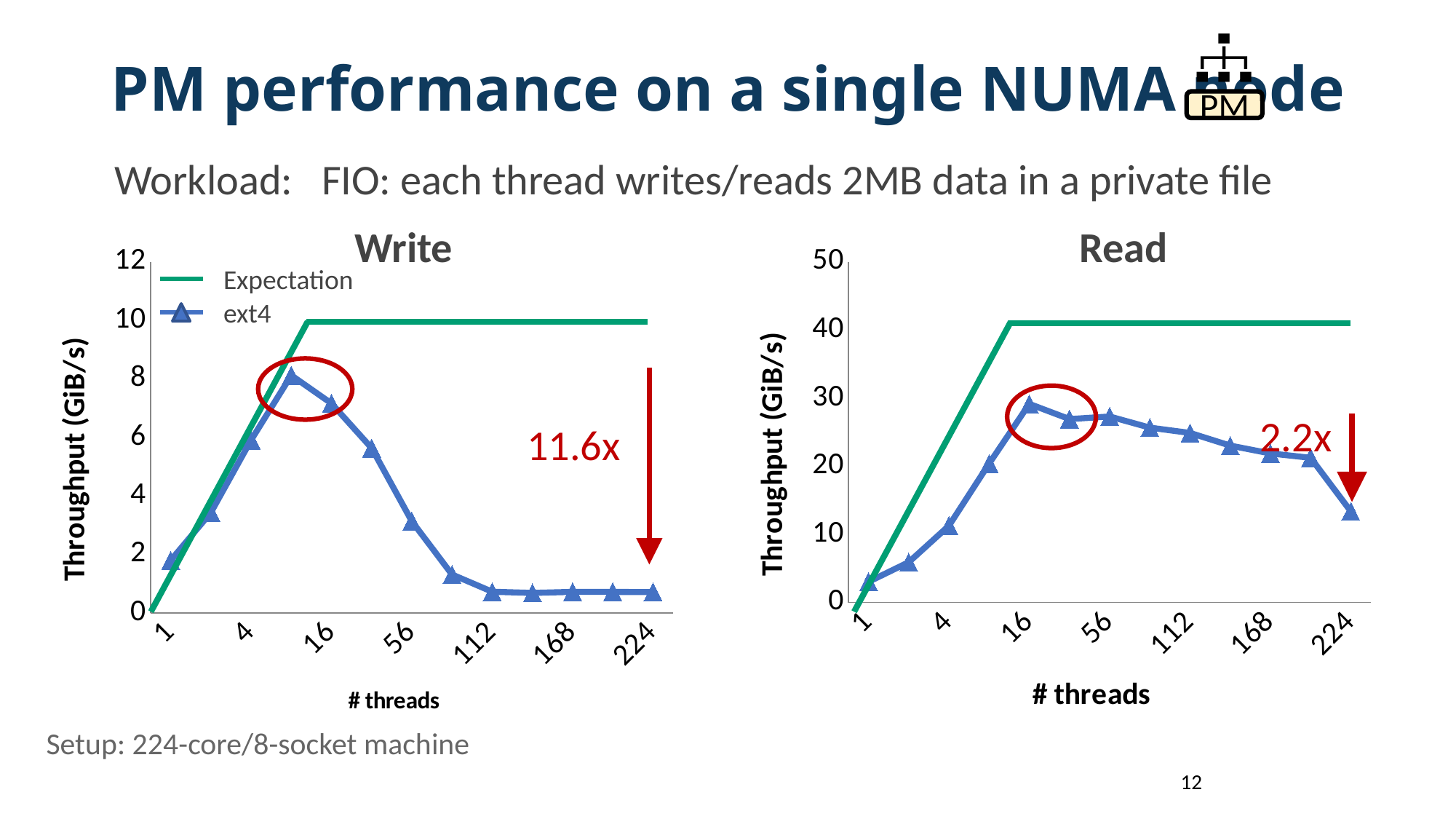
On the Read chart, does the ext4 throughput rise or fall from 56 threads to 224 threads? fall How many tick labels are shown on the x axis of the Read chart? 7 What kind of chart is the Write chart? line chart On the Read chart, is the ext4 throughput at 224 threads greater or less than 20? less On the Read chart, which series is higher at 112 threads, Expectation or ext4? Expectation On the Write chart, does the ext4 throughput rise or fall from 16 threads to 224 threads? fall How many series does the legend on the Write chart list? 2 What factor is annotated in red on the Write chart? 11.6x On the Read chart, is the ext4 throughput at 224 threads greater or less than 10? greater On the Write chart, what are the two series named in the legend? Expectation and ext4 On the Write chart, is the ext4 throughput at 224 threads greater or less than 2? less